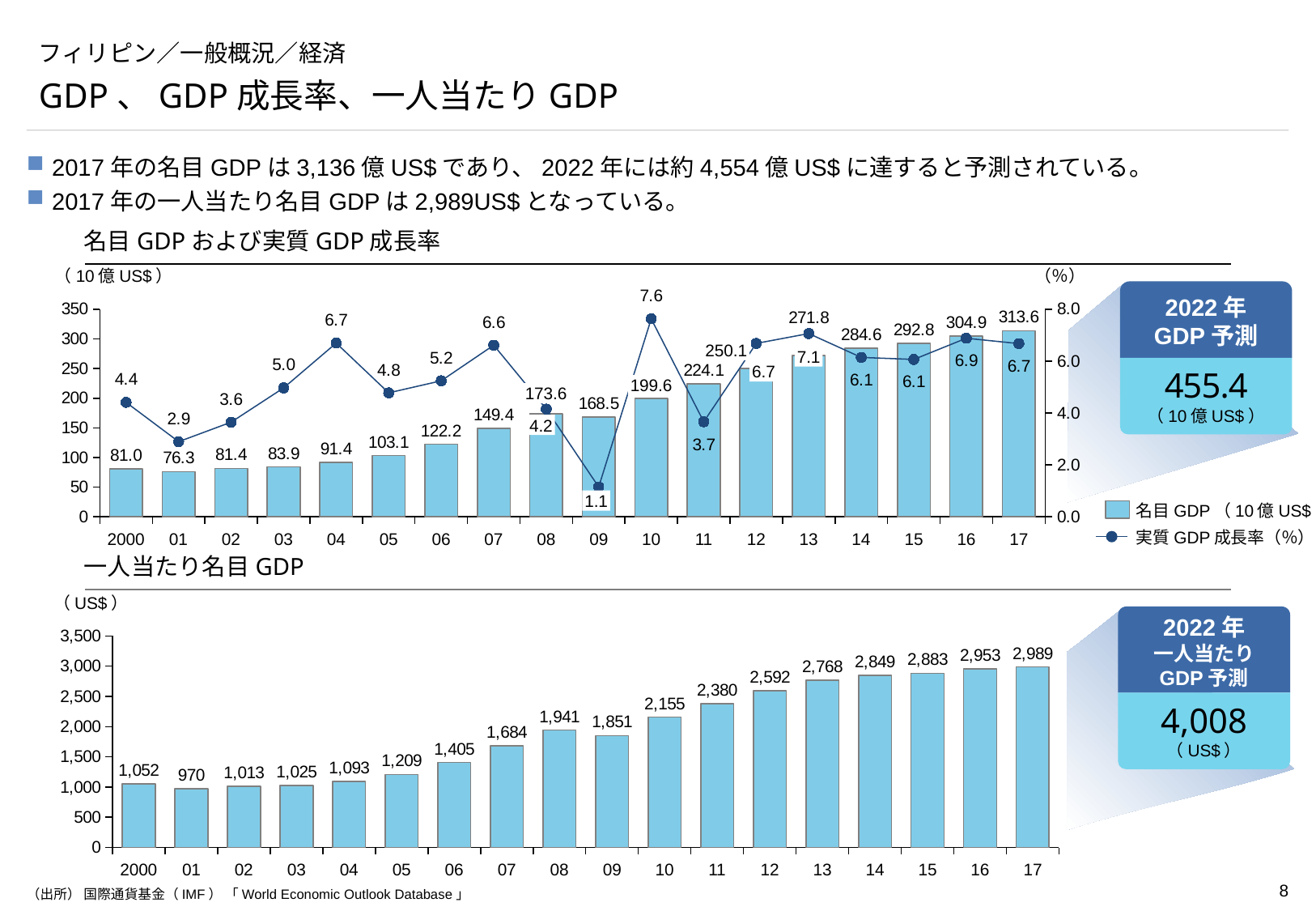
In the top chart (名目GDPおよび実質GDP成長率), which year has the lowest nominal GDP? 2001 (76.3) How many years are plotted in the bottom chart (一人当たり名目GDP)? 18 In the bottom chart (一人当たり名目GDP), which is larger, the value for 2008 or 2009? 2008 What kind of chart is the bottom chart (一人当たり名目GDP)? Bar chart How many series does the legend of the top chart (名目GDPおよび実質GDP成長率) list? 2 In the bottom chart (一人当たり名目GDP), what is the value for 2008? 1,941 In the bottom chart (一人当たり名目GDP), what is the difference between the values for 2017 and 2016? 36 What is the 2022 forecast for per-capita GDP shown in the box next to the bottom chart? 4,008 (US$) In the top chart (名目GDPおよび実質GDP成長率), what is the real GDP growth rate for 2009? 1.1 In the top chart (名目GDPおよび実質GDP成長率), which year has the highest real GDP growth rate? 2010 (7.6) In the top chart (名目GDPおよび実質GDP成長率), what is the difference between nominal GDP in 2017 and 2016? 8.7 In the top chart (名目GDPおよび実質GDP成長率), what is the nominal GDP value for 2010? 199.6